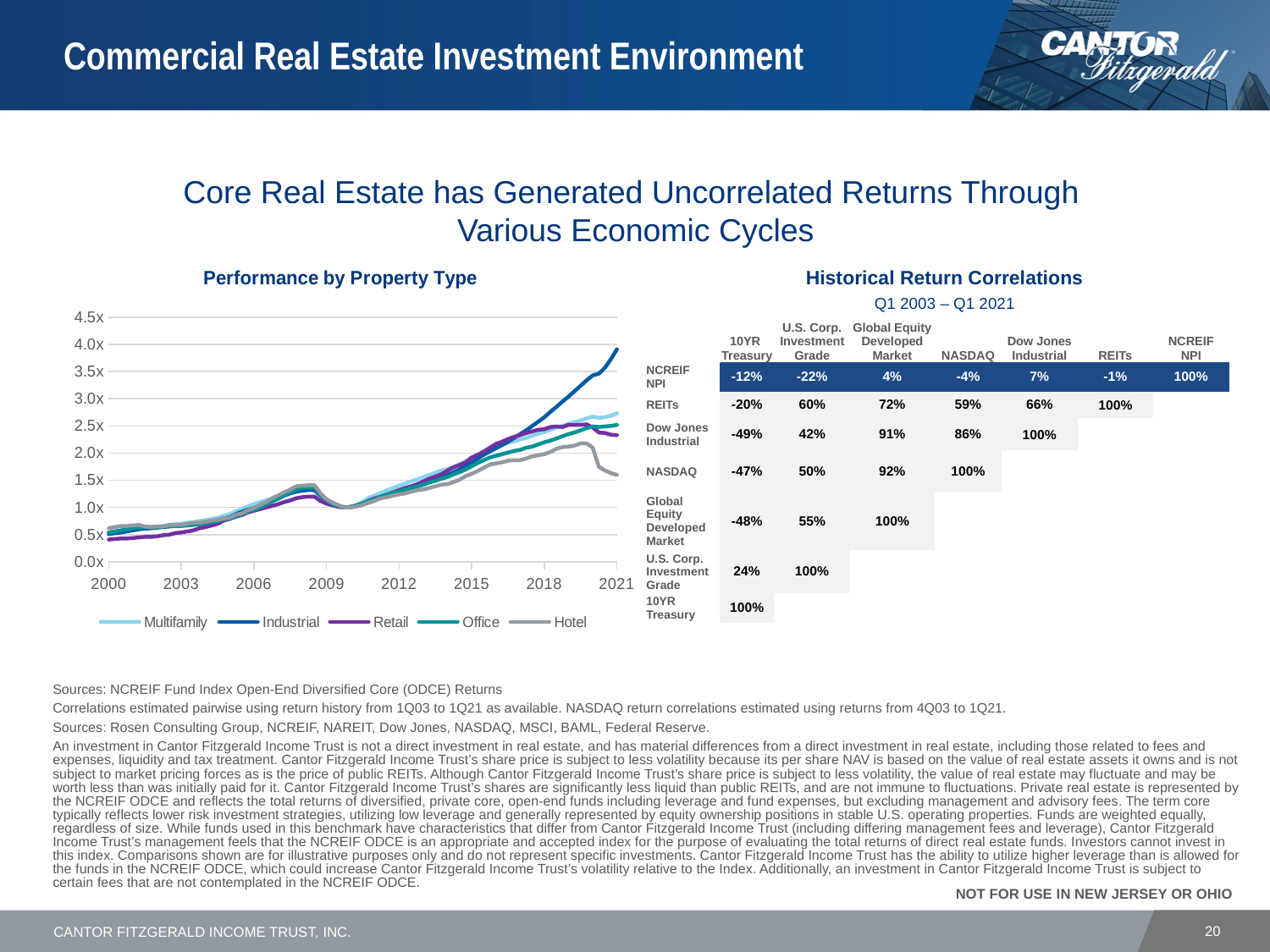
In the "Performance by Property Type" chart, which property type has the lowest value in 2021? Hotel In the "Performance by Property Type" chart, does the Industrial line rise or fall overall from 2000 to 2021? rise Which series are listed in the legend of the "Performance by Property Type" chart? Multifamily, Industrial, Retail, Office, Hotel In the "Performance by Property Type" chart, does the Hotel line rise or fall between 2019 and 2021? fall In the "Performance by Property Type" chart, is the value for Hotel in 2021 greater or less than 2.0x? less In the "Performance by Property Type" chart, which is larger in 2021, Industrial or Hotel? Industrial What is the first year and the last year labelled on the x axis of the "Performance by Property Type" chart? 2000 and 2021 How many series does the legend of the "Performance by Property Type" chart list? 5 In the "Performance by Property Type" chart, is the value for Industrial in 2021 greater or less than 3.5x? greater In the "Performance by Property Type" chart, which property type has the highest value in 2021? Industrial In the "Performance by Property Type" chart, is the value for Retail in 2021 greater or less than 2.0x? greater What kind of chart is the "Performance by Property Type" chart? line chart